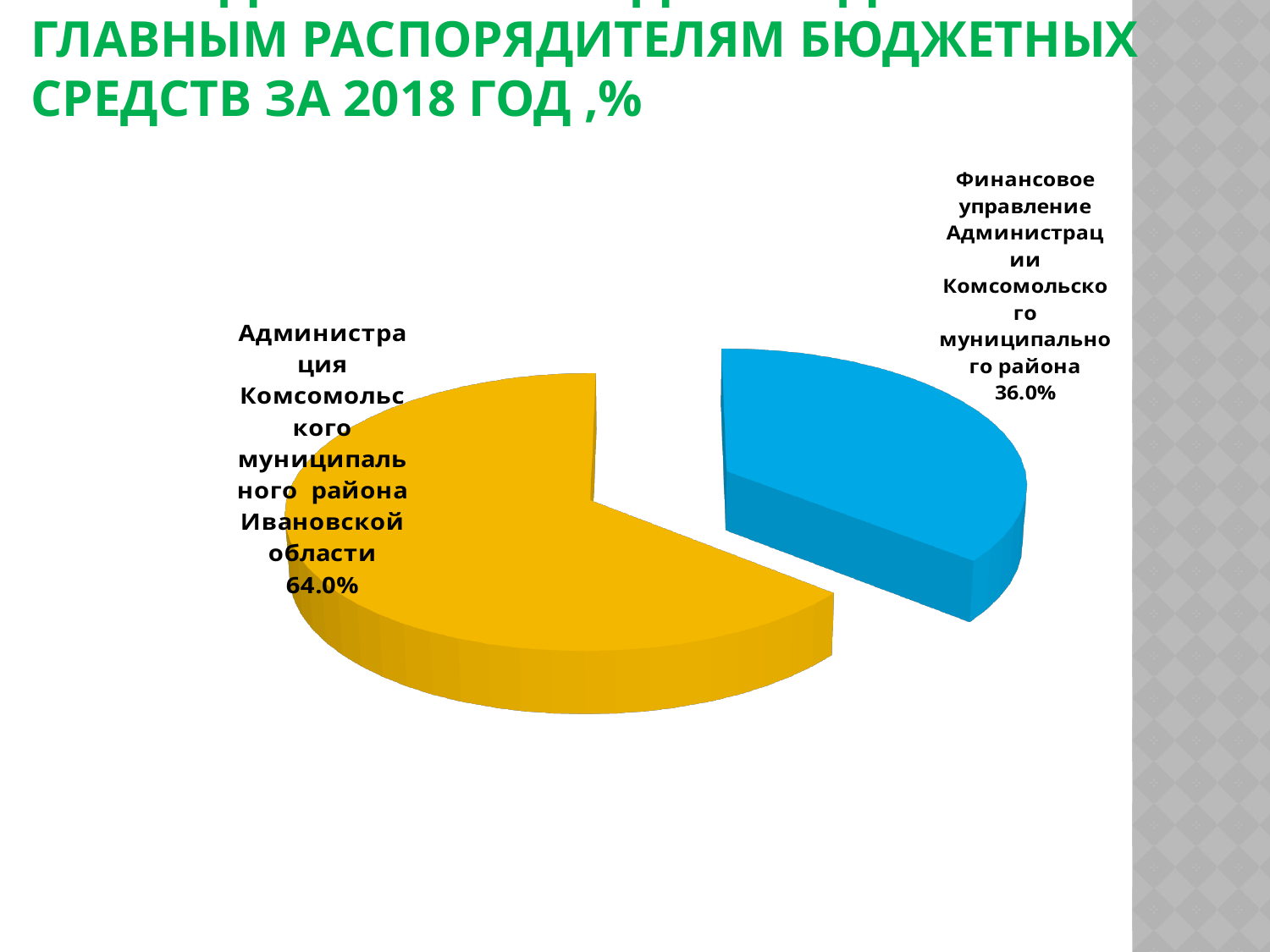
What share of the pie is labelled for Администрация Комсомольского муниципального района Ивановской области? 64.0% Which category has the largest slice of the pie? Администрация Комсомольского муниципального района Ивановской области What is the total of the two slice percentages shown on the pie chart? 100.0% Which year does the chart title say the data is for? 2018 How many slices does the pie chart have? 2 What kind of chart is shown on the slide? Pie chart What colour is the slice for Администрация Комсомольского муниципального района Ивановской области? Yellow What share of the pie is labelled for Финансовое управление Администрации Комсомольского муниципального района? 36.0% Which category has the smallest slice of the pie? Финансовое управление Администрации Комсомольского муниципального района What colour is the slice for Финансовое управление Администрации Комсомольского муниципального района? Blue Which is larger: the slice for Администрация Комсомольского муниципального района Ивановской области or the slice for Финансовое управление? Администрация Комсомольского муниципального района Ивановской области What is the difference in percentage points between the Администрация slice and the Финансовое управление slice? 28.0